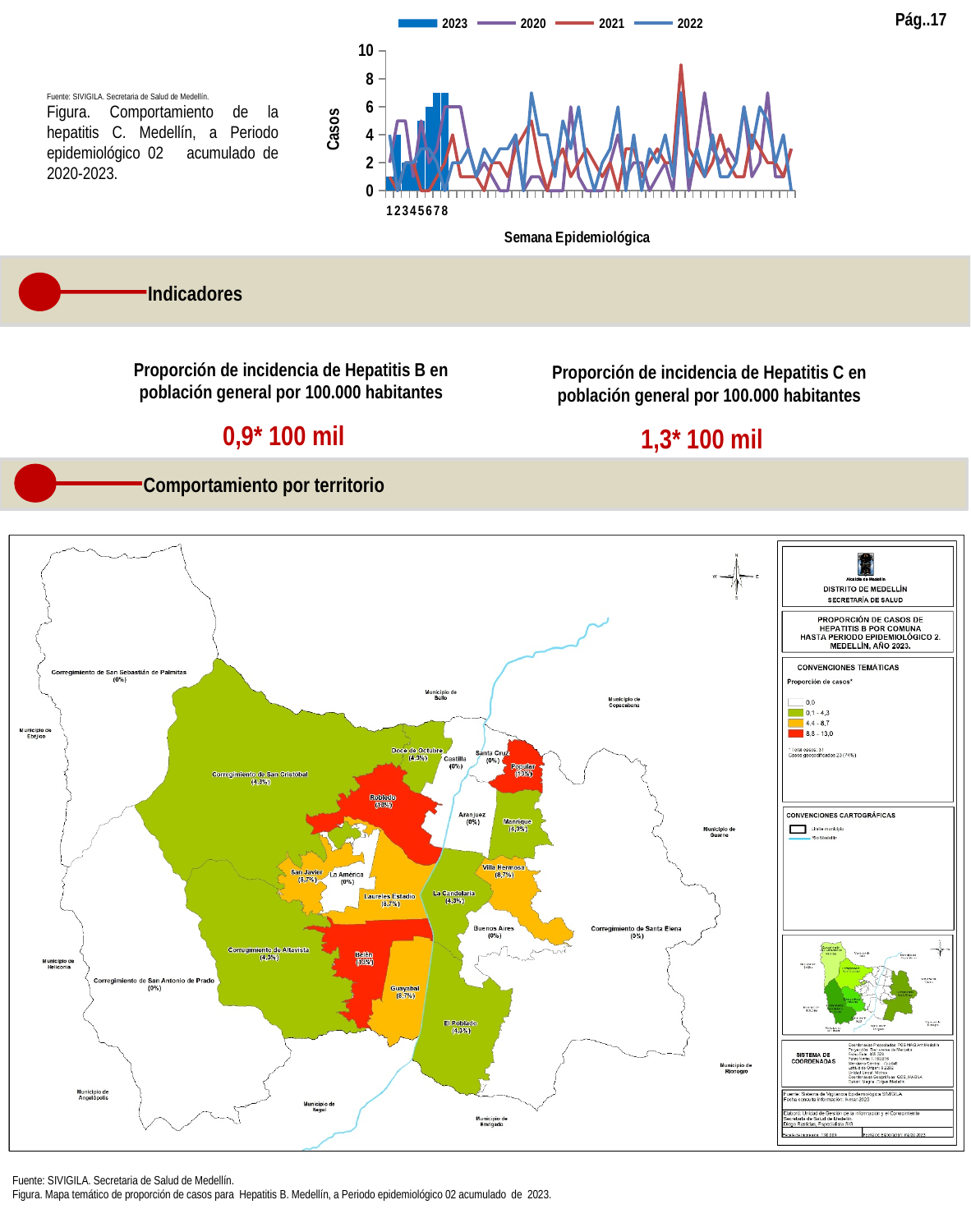
What is the highest tick value shown on the vertical axis of the hepatitis C chart? 10 Is the peak value of the 2021 series in the hepatitis C chart greater or less than 8? greater Which series is drawn as bars rather than a line in the hepatitis C chart? 2023 Is the 2023 value for week 7 in the hepatitis C chart greater or less than 6? greater Is the peak value of the 2021 series in the hepatitis C chart greater or less than 10? less Which years are listed in the legend of the hepatitis C chart? 2023, 2020, 2021, 2022 What is the label of the vertical axis of the hepatitis C chart? Casos Which series reaches the highest number of cases in the hepatitis C chart? 2021 How many series does the legend of the hepatitis C chart list? 4